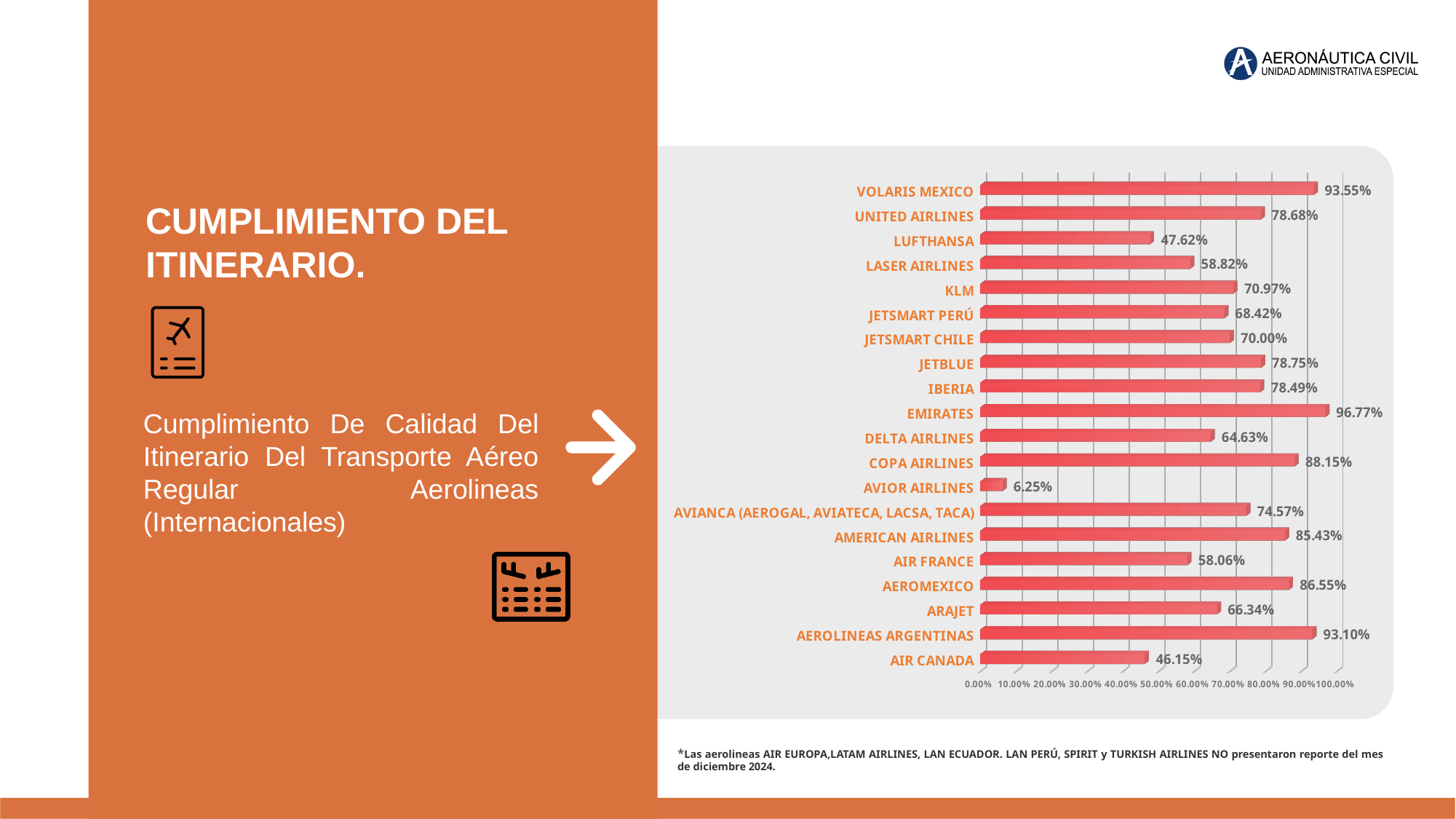
What is the value for AVIANCA (AEROGAL, AVIATECA, LACSA, TACA)? 74.57% Which airline has the highest value in the chart? EMIRATES Which is larger, the value for AEROMEXICO or the value for AMERICAN AIRLINES? AEROMEXICO What is the difference between the values for COPA AIRLINES and DELTA AIRLINES? 23.52% What is the difference between the values for EMIRATES and AVIOR AIRLINES? 90.52% How many airlines are shown in the chart? 20 Which airline has the lowest value in the chart? AVIOR AIRLINES What is the value for AIR CANADA? 46.15% Is the value for AIR FRANCE greater or less than 60.00%? less What kind of chart is shown on the slide? bar chart What is the highest tick value shown on the horizontal axis of the chart? 100.00% What is the value for EMIRATES? 96.77%